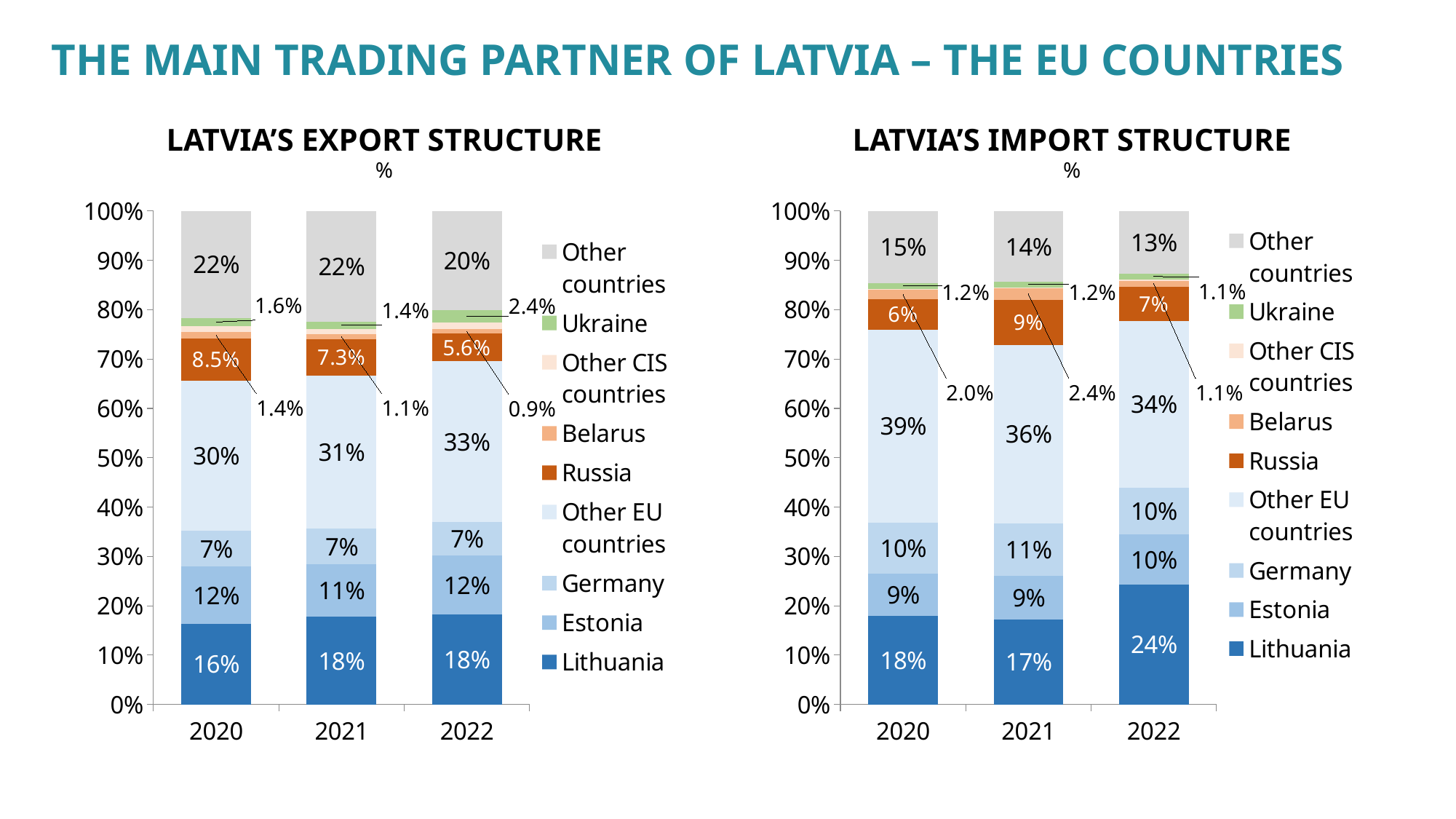
In the Latvia's Export Structure chart, does the share of Other EU countries rise or fall from 2020 to 2022? Rise In the Latvia's Import Structure chart, which year had the larger share for Lithuania, 2020 or 2022? 2022 In the Latvia's Import Structure chart, does the share of Other countries rise or fall from 2020 to 2022? Fall In the Latvia's Import Structure chart, what share did Other EU countries have in 2020? 39% In the Latvia's Export Structure chart, what share did Lithuania have in 2020? 16% In the Latvia's Import Structure chart, what share did Lithuania have in 2022? 24% In the Latvia's Import Structure chart, which year has the highest share for Russia? 2021 What kind of chart is the Latvia's Export Structure chart? Stacked bar chart How many years are shown on the x axis of the Latvia's Export Structure chart? 3 How many series does the legend of the Latvia's Import Structure chart list? 9 In the Latvia's Export Structure chart, what share did Russia have in 2022? 5.6% In the Latvia's Export Structure chart, by how many percentage points did Russia's share fall from 2020 to 2022? 2.9 percentage points